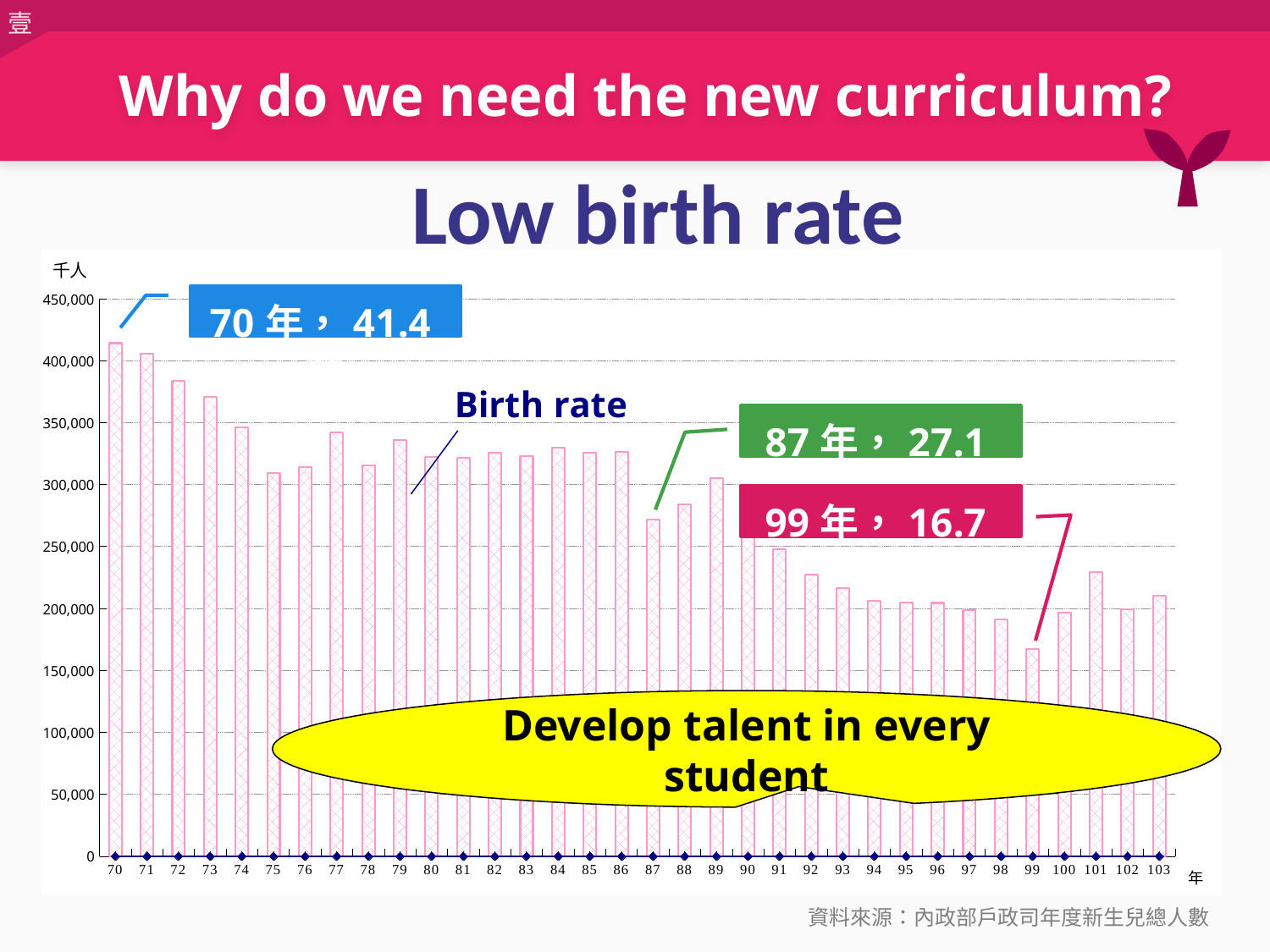
How many years (bars) are plotted on the x axis of the chart? 34 Is the value for year 92 greater or less than 250,000? less What kind of chart is shown on the slide? bar chart Is the value for year 87 greater or less than 300,000? less Overall, do the bar values rise or fall from year 70 to year 103? fall Which is larger, the value for year 80 or the value for year 90? year 80 Which year has the highest bar in the chart? 70 What value does the callout for 87 年 show? 27.1 What unit label is printed at the top of the y axis? 千人 Which year has the lowest bar in the chart? 99 Is the value for year 70 greater or less than 400,000? greater